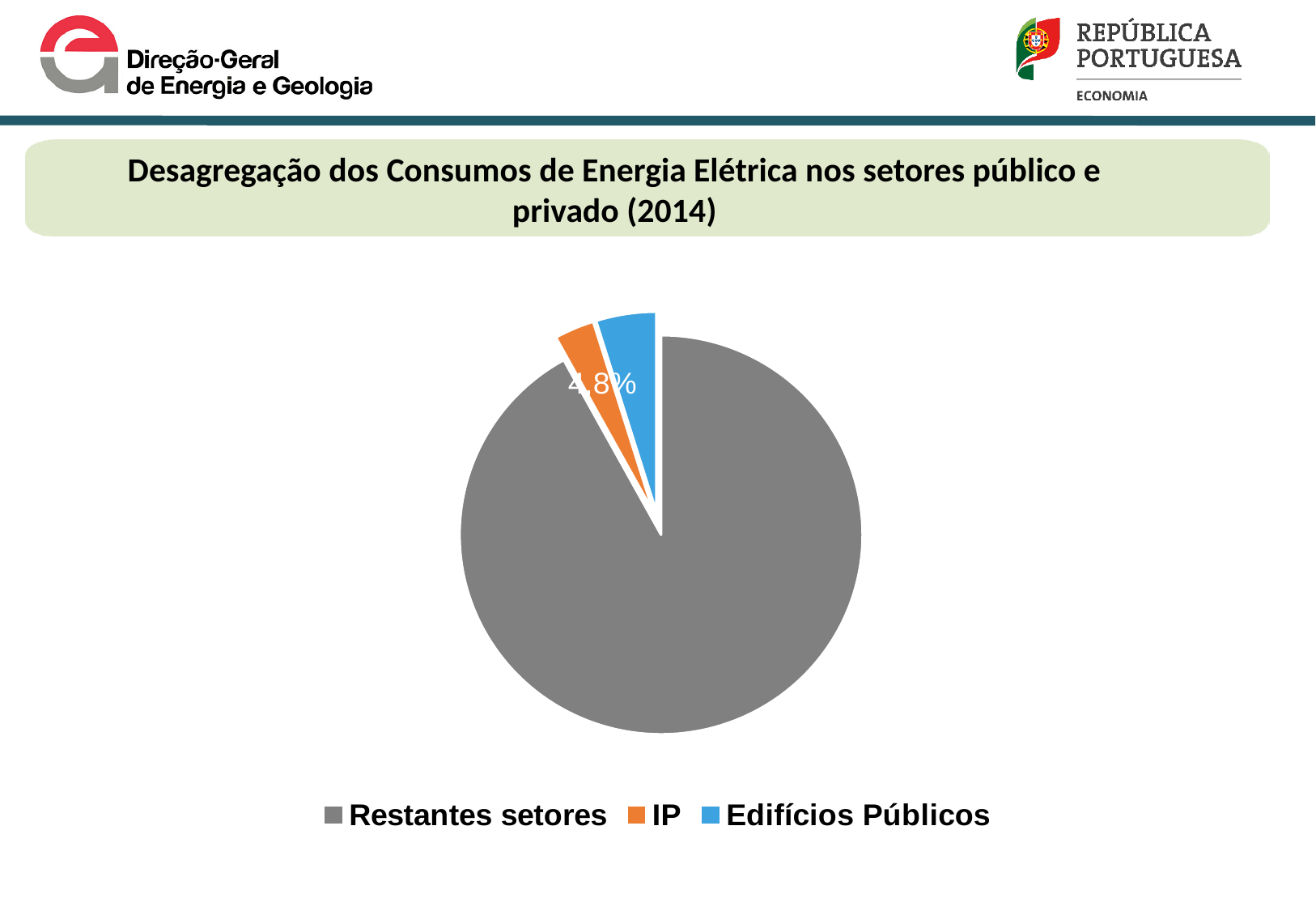
What percentage value is printed as a data label on the pie chart? 4.8% How many slices does the pie chart have? 3 What colour is the IP slice in the pie chart? orange Which category has the largest slice of the pie chart? Restantes setores What colour is the Edifícios Públicos slice in the pie chart? blue Which is larger in the pie chart, Restantes setores or IP? Restantes setores How many entries does the legend of the pie chart list? 3 What kind of chart is shown on the slide? pie chart Which year does the chart title refer to? 2014 Which is larger in the pie chart, Edifícios Públicos or Restantes setores? Restantes setores